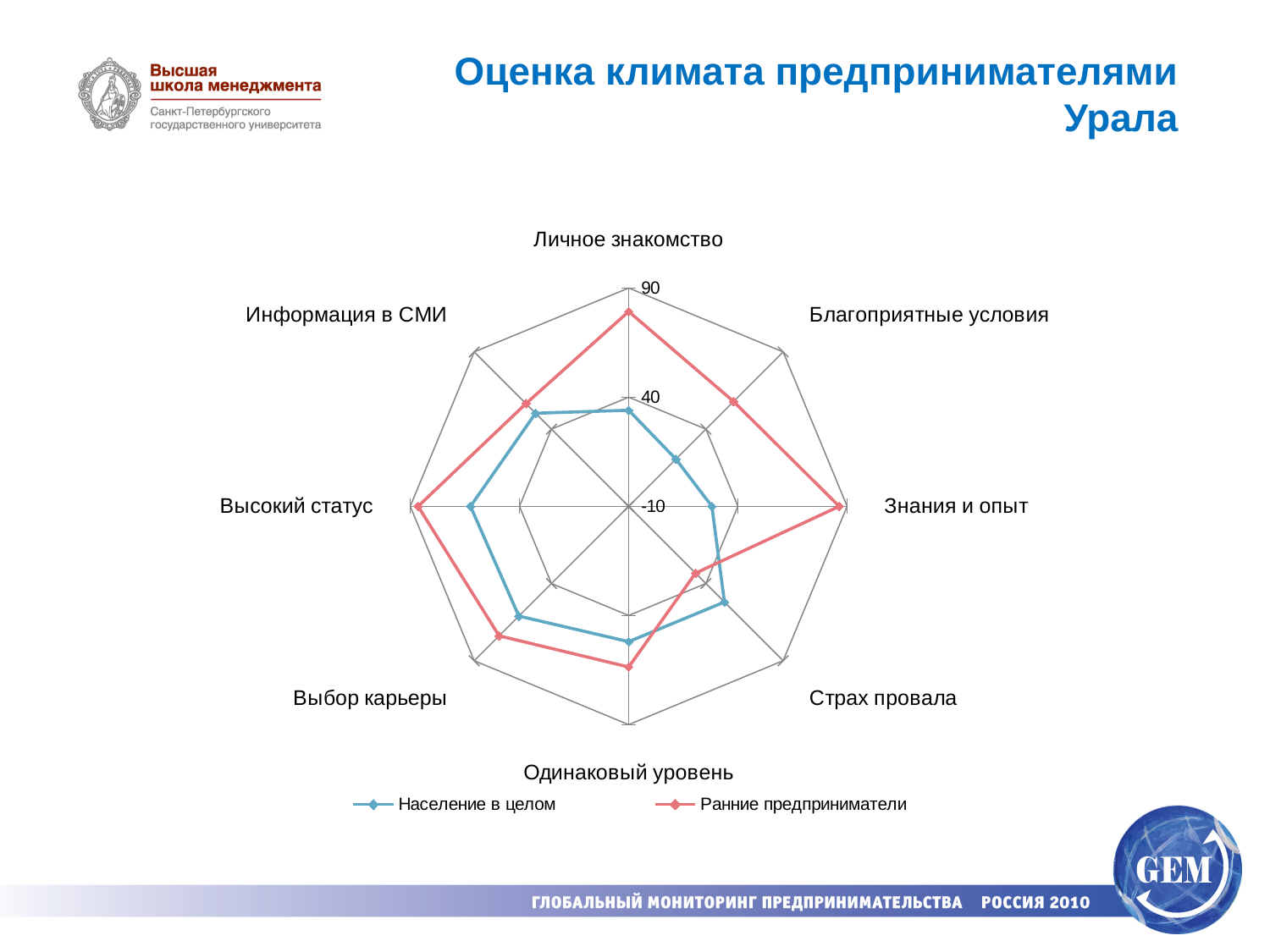
For Знания и опыт, which series has the larger value, Население в целом or Ранние предприниматели? Ранние предприниматели Is the value for Знания и опыт for Ранние предприниматели greater or less than 40? greater How many series does the legend list? 2 What is the title of the slide containing the chart? Оценка климата предпринимателями Урала Which series is drawn in red? Ранние предприниматели Is the value for Страх провала for Население в целом greater or less than 40? greater Is the value for Личное знакомство for Ранние предприниматели greater or less than 40? greater How many categories (axes) does the radar chart have? 8 For the Ранние предприниматели series, which category has the lowest value? Страх провала For Страх провала, which series has the larger value, Население в целом or Ранние предприниматели? Население в целом What kind of chart is shown on the slide? Radar chart